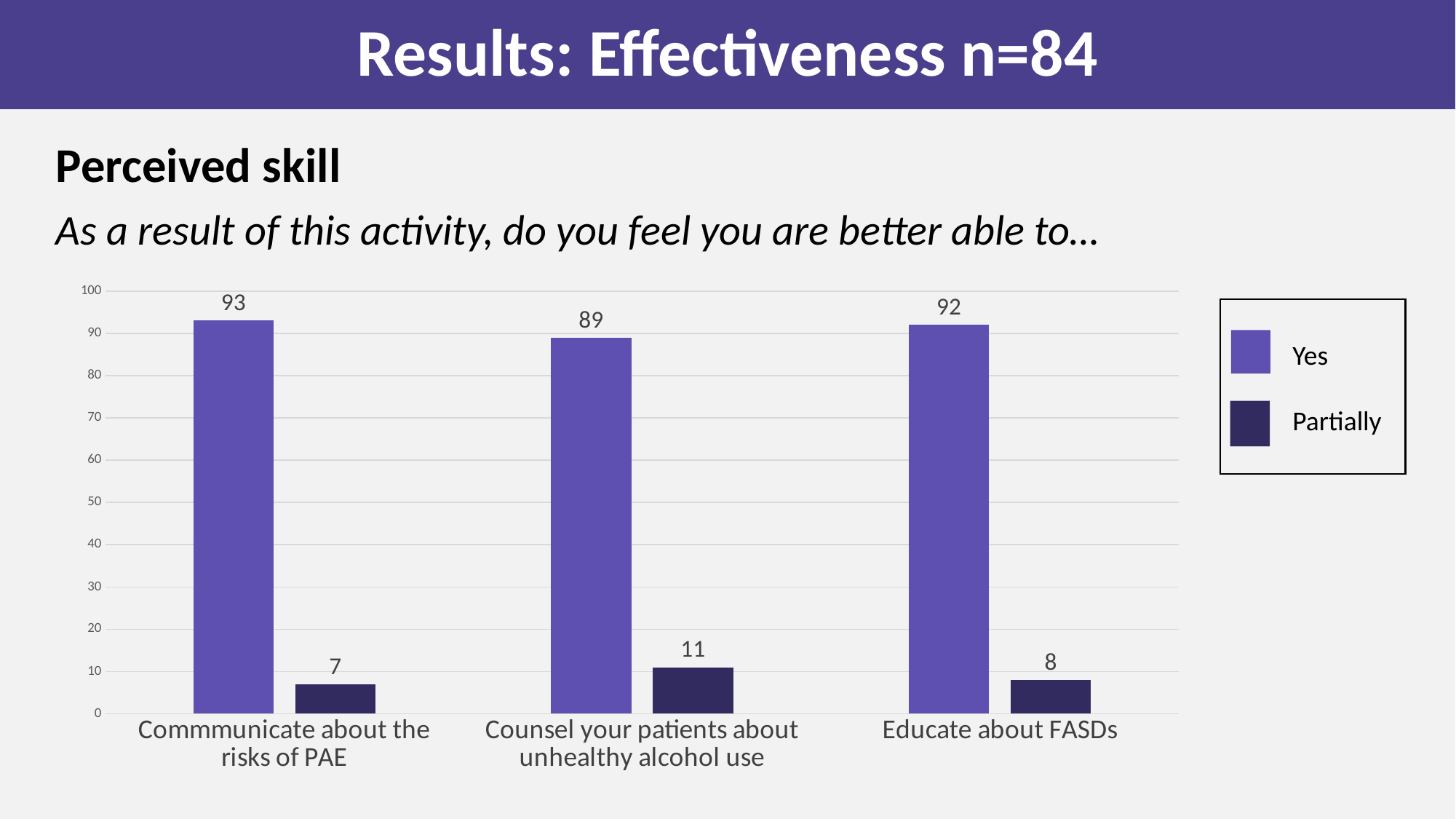
What are the two entries in the chart legend? Yes, Partially Which category has the highest 'Yes' value? Commmunicate about the risks of PAE How many categories are shown on the x axis? 3 What is the 'Yes' value for 'Educate about FASDs'? 92 What is the 'Yes' value for 'Commmunicate about the risks of PAE'? 93 How many series does the legend list? 2 Is the 'Yes' value for 'Counsel your patients about unhealthy alcohol use' greater or less than 80? greater Which is larger: the 'Partially' value for 'Educate about FASDs' or the 'Partially' value for 'Commmunicate about the risks of PAE'? Educate about FASDs What kind of chart is shown on the slide? bar chart What is the 'Partially' value for 'Counsel your patients about unhealthy alcohol use'? 11 What is the difference between the 'Yes' and 'Partially' values for 'Counsel your patients about unhealthy alcohol use'? 78 Which category has the lowest 'Partially' value? Commmunicate about the risks of PAE